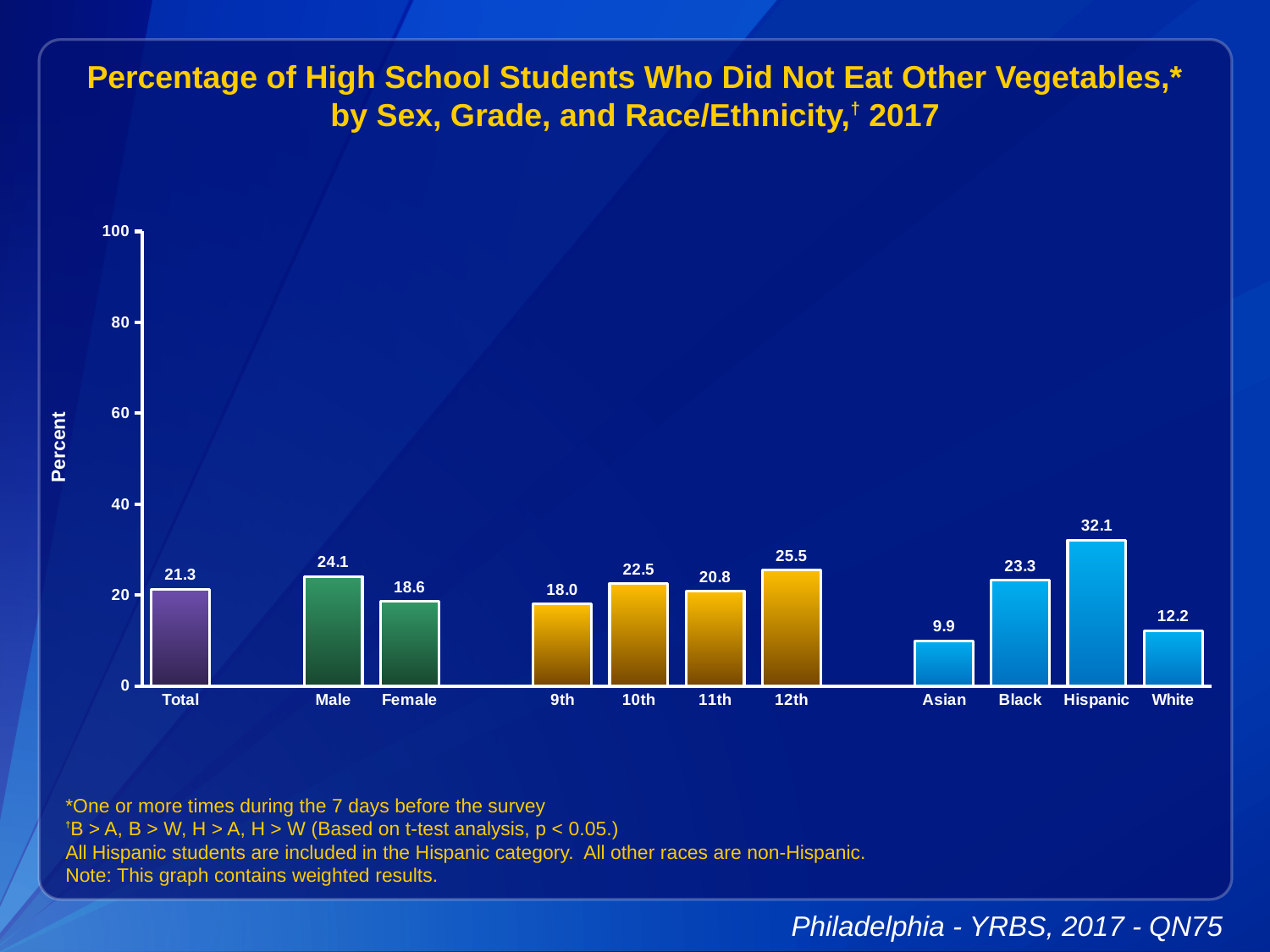
Which category has the lowest value? Asian What is the value for Total? 21.3 What is the value for Hispanic students? 32.1 What is the label on the y axis? Percent What is the value for 9th grade? 18.0 Which category has the highest value? Hispanic Is the value for Black students greater or less than 20? greater How many categories are shown on the x axis? 11 What is the difference between the values for Male and Female? 5.5 What kind of chart is this? bar chart Which is larger, the value for 12th grade or the value for 10th grade? 12th Do the values rise or fall from 9th grade to 12th grade? rise